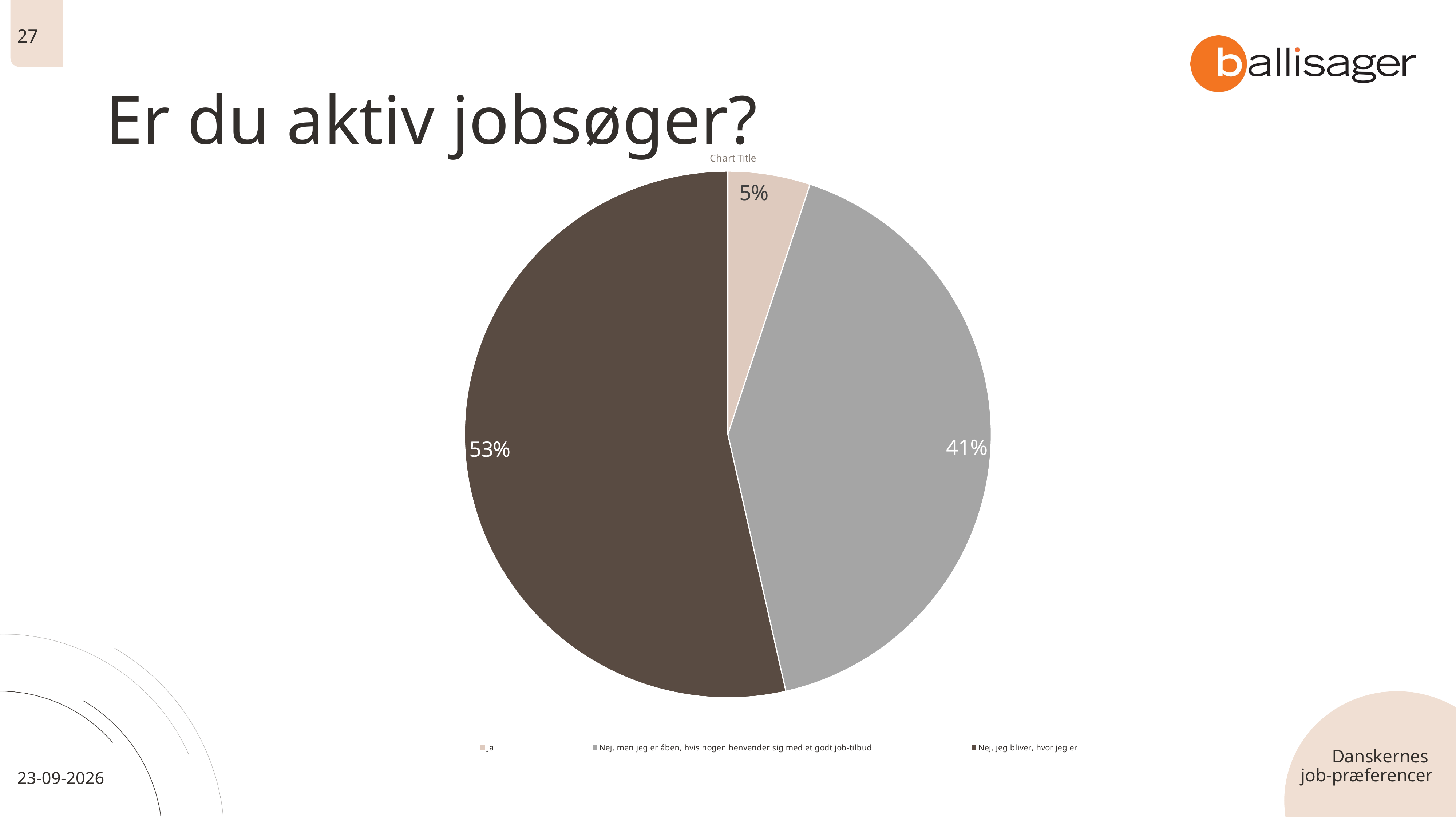
Which category has the smallest slice of the pie? Ja What kind of chart is shown on the slide? pie chart What is the difference in percentage points between "Nej, jeg bliver, hvor jeg er" and "Nej, men jeg er åben, hvis nogen henvender sig med et godt job-tilbud"? 12 percentage points What share of the pie does "Nej, men jeg er åben, hvis nogen henvender sig med et godt job-tilbud" have? 41% Which category has the largest slice of the pie? Nej, jeg bliver, hvor jeg er What share of the pie does "Ja" have? 5% What is the difference in percentage points between "Nej, men jeg er åben, hvis nogen henvender sig med et godt job-tilbud" and "Ja"? 36 percentage points What share of the pie does "Nej, jeg bliver, hvor jeg er" have? 53% Which is larger: the slice for "Ja" or the slice for "Nej, jeg bliver, hvor jeg er"? Nej, jeg bliver, hvor jeg er How many slices does the pie chart have? 3 What colour is the slice for "Nej, jeg bliver, hvor jeg er"? dark brown What is the title of the slide containing the pie chart? Er du aktiv jobsøger?